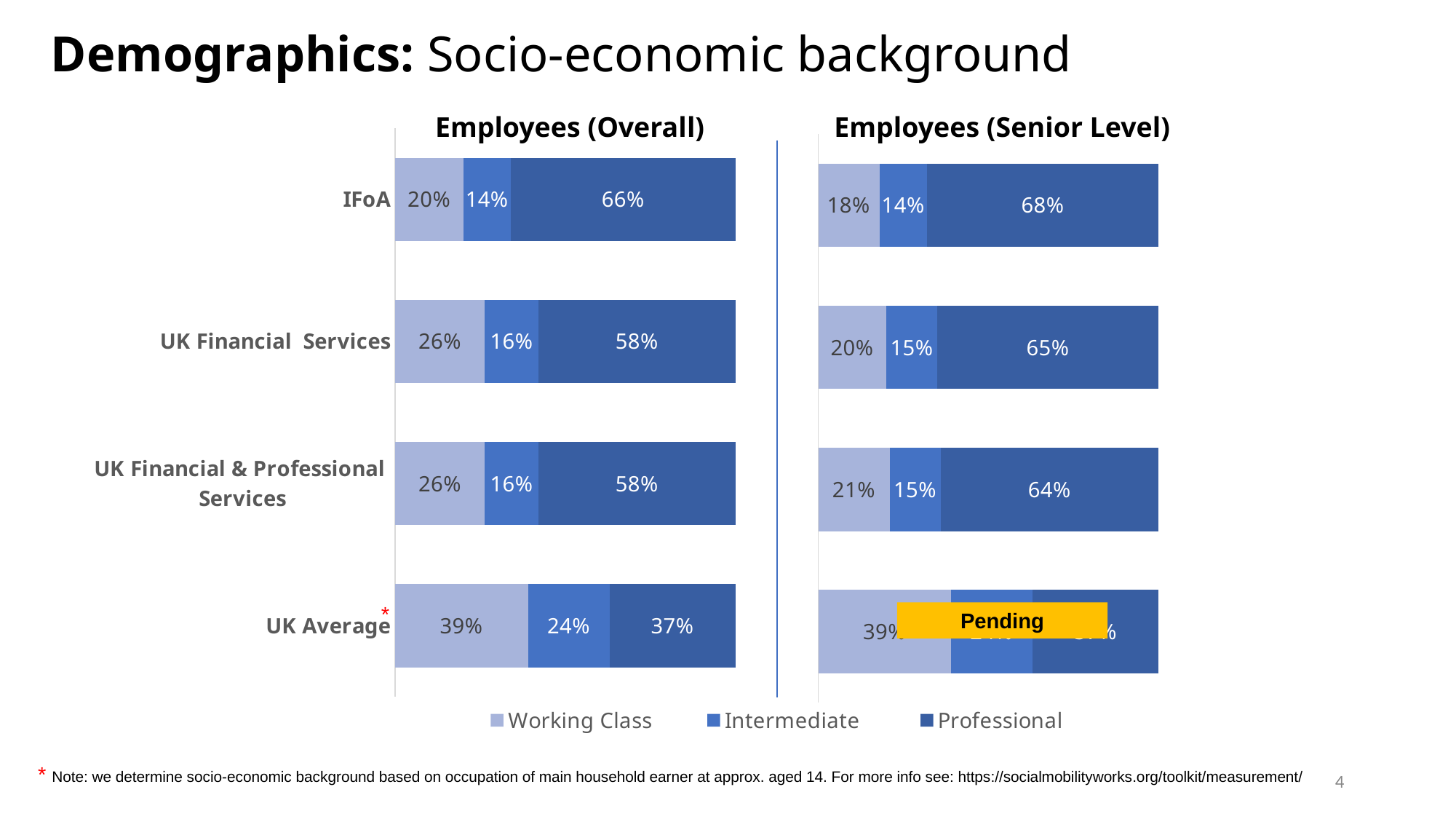
In the Employees (Senior Level) chart, what is the Working Class share for UK Financial & Professional Services? 21% In the Employees (Senior Level) chart, is the Professional share larger for IFoA or for UK Financial & Professional Services? IFoA In the Employees (Senior Level) chart, what is the Professional share for UK Financial Services? 65% How many series does the legend list? 3 In the Employees (Senior Level) chart, what label covers the UK Average bar? Pending In the Employees (Senior Level) chart, which category has the lowest Working Class share? IFoA In the Employees (Overall) chart, what is the Intermediate share for UK Average? 24% In the Employees (Overall) chart, which category has the highest Working Class share? UK Average How many categories are shown in the Employees (Overall) chart? 4 In the Employees (Overall) chart, what is the difference between the Professional share for IFoA and for UK Average? 29% In the Employees (Overall) chart, what is the Professional share for IFoA? 66% What kind of chart is the Employees (Overall) chart? Stacked bar chart